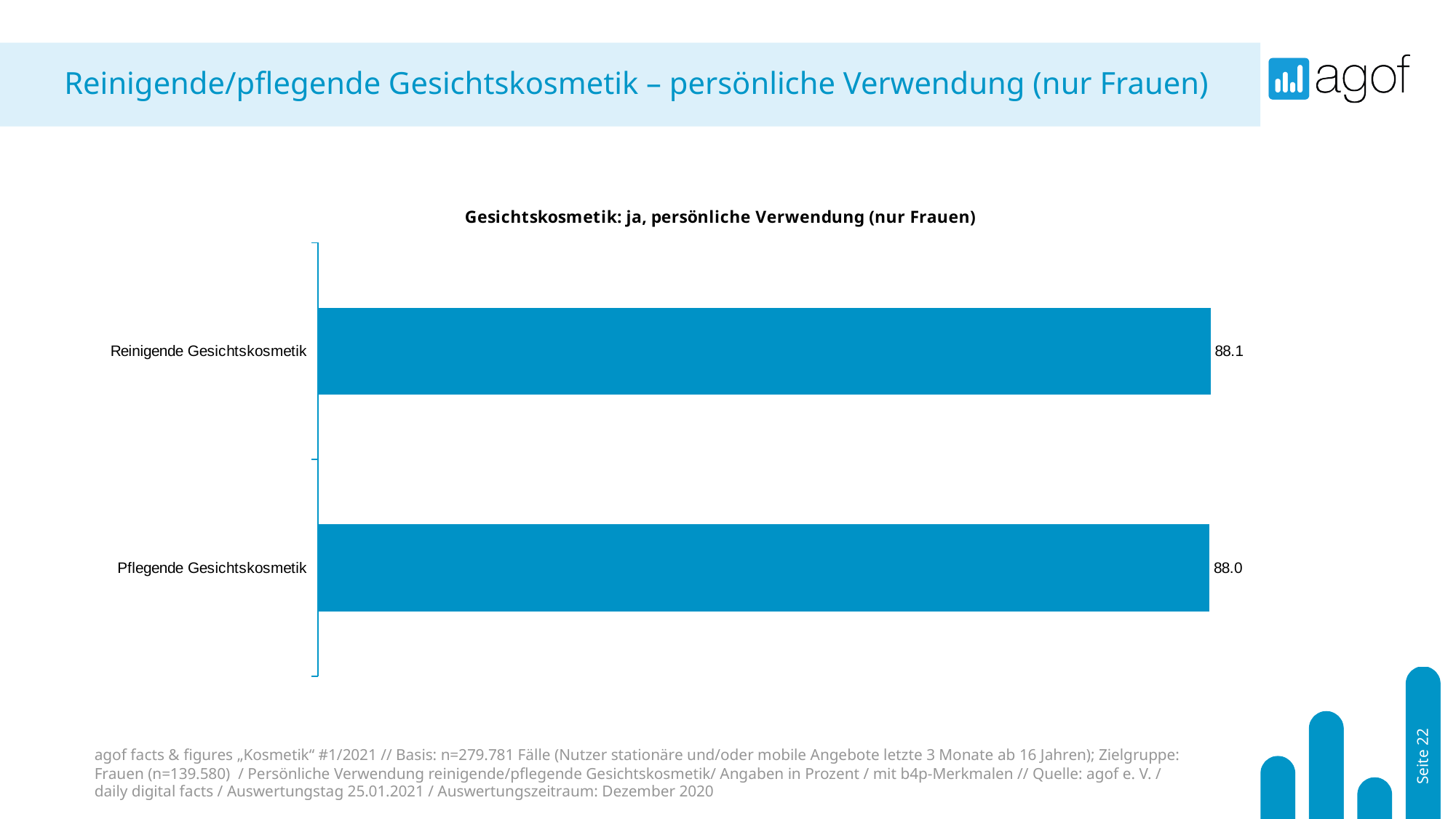
What kind of chart is shown on the slide? Bar chart What is the title of the chart? Gesichtskosmetik: ja, persönliche Verwendung (nur Frauen) What colour are the bars in the chart? Blue Which is larger, the value for Reinigende Gesichtskosmetik or the value for Pflegende Gesichtskosmetik? Reinigende Gesichtskosmetik Which category has the lowest value? Pflegende Gesichtskosmetik What is the difference between the values for Reinigende Gesichtskosmetik and Pflegende Gesichtskosmetik? 0.1 What is the value for Reinigende Gesichtskosmetik? 88.1 How many categories are shown in the chart? 2 What is the value for Pflegende Gesichtskosmetik? 88.0 Which category has the highest value? Reinigende Gesichtskosmetik